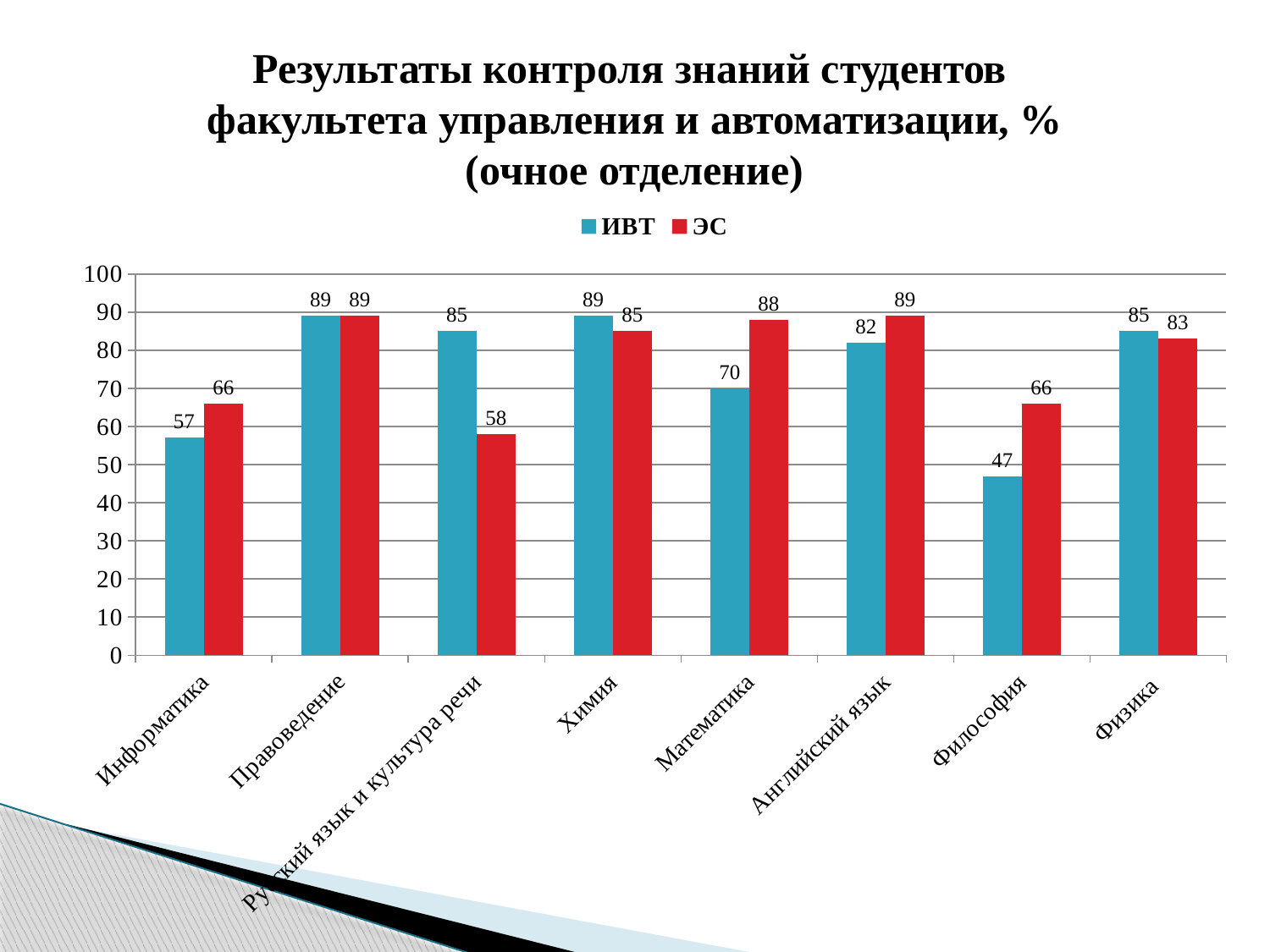
Which subject has the lowest ИВТ value? Философия What is the ЭС value for Математика? 88 What kind of chart is shown on the slide? bar chart Which series is shown in red in the legend? ЭС Which subject has the lowest ЭС value? Русский язык и культура речи How many series does the legend list? 2 What is the difference between the ЭС and ИВТ values for Философия? 19 How many subject categories are shown on the x axis? 8 What is the ИВТ value for Философия? 47 What is the difference between the ИВТ and ЭС values for Русский язык и культура речи? 27 What is the ИВТ value for Информатика? 57 For Математика, which series has the larger value, ИВТ or ЭС? ЭС